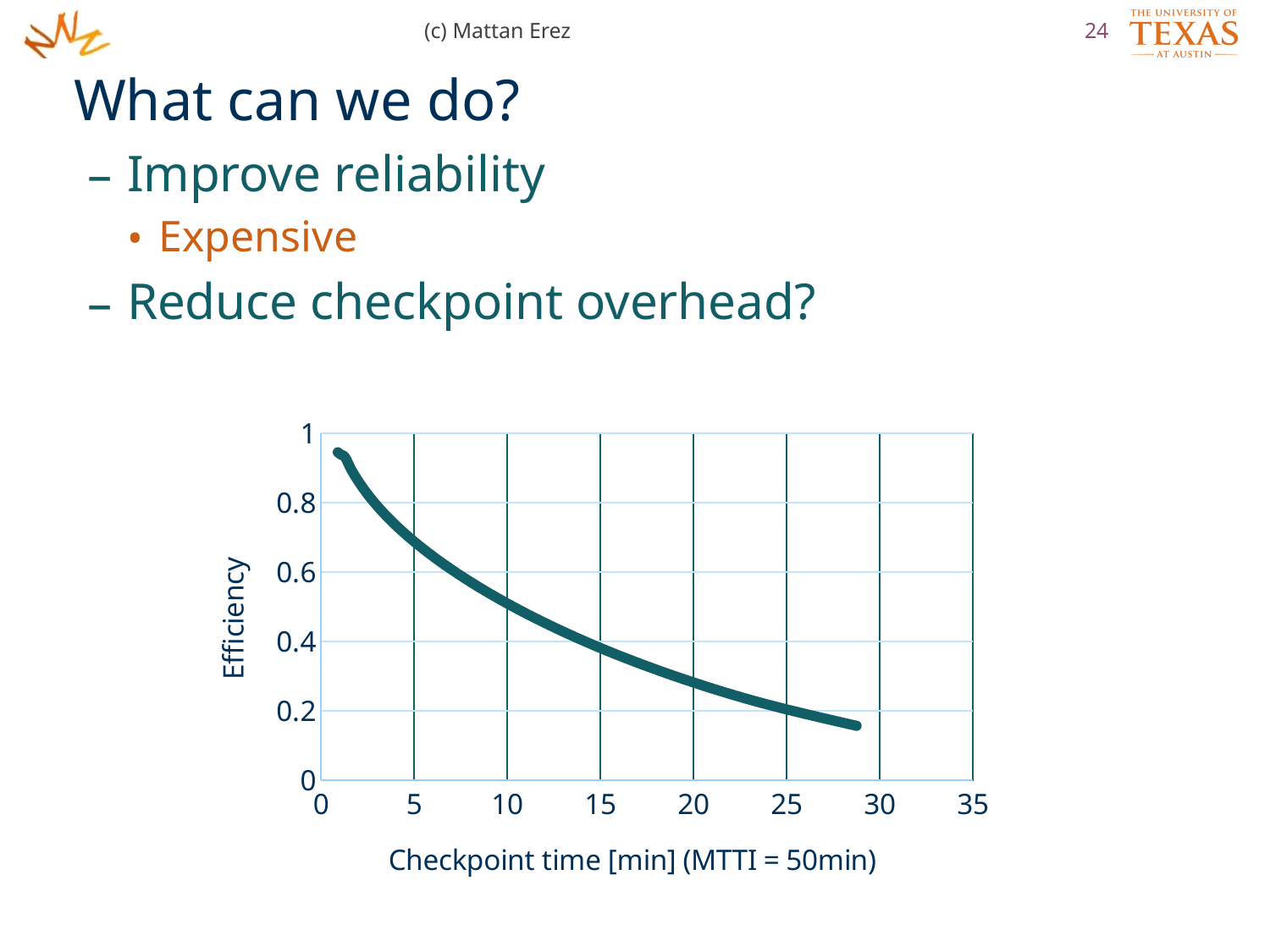
Does efficiency rise or fall as checkpoint time increases along the x axis? fall What is the label of the y axis of the chart? Efficiency Is the efficiency at a checkpoint time of 20 minutes greater or less than 0.2? greater Is the efficiency at a checkpoint time of 10 minutes greater or less than 0.4? greater Is the efficiency at a checkpoint time of 10 minutes greater or less than 0.6? less What kind of chart is shown on the slide? line chart Is the efficiency at a checkpoint time of 5 minutes greater or less than the efficiency at 20 minutes? greater What is the label of the x axis of the chart? Checkpoint time [min] (MTTI = 50min)